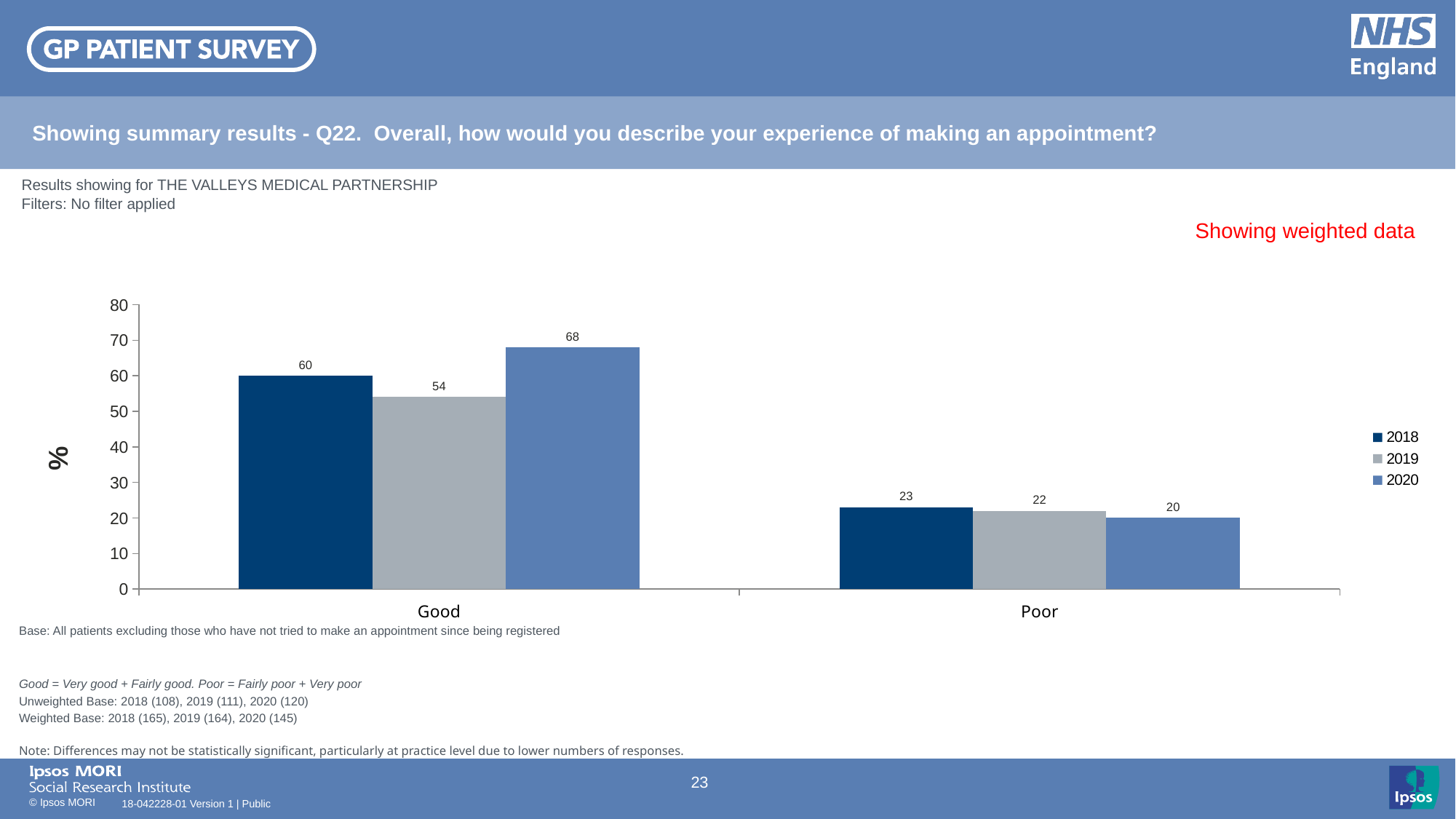
How many series does the legend list? 3 Do the values in the Poor category rise or fall from 2018 to 2020? Fall How many categories are shown on the x axis? 2 Which year has the lowest value in the Poor category? 2020 What is the value for 2018 in the Good category? 60 Which is larger: the 2018 value for Good or the 2018 value for Poor? 2018 value for Good Which year has the highest value in the Good category? 2020 What kind of chart is shown on the slide? Bar chart What is the value for 2020 in the Good category? 68 What is the value for 2019 in the Poor category? 22 What is the label on the y axis? % What is the difference between the 2020 and 2019 values in the Good category? 14